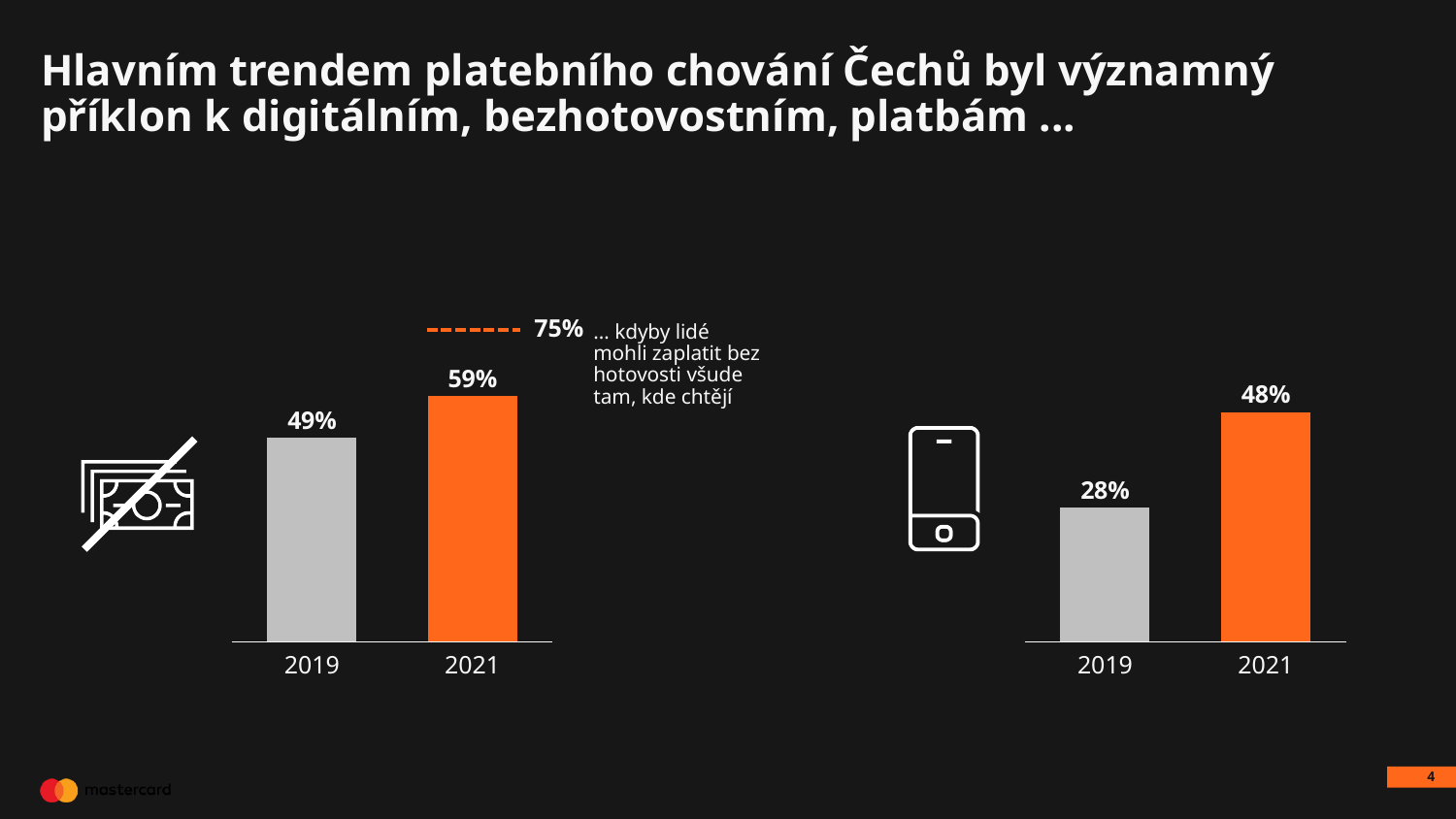
In the left chart, what value is marked by the dashed line above the bars? 75% What type of chart is the right chart? bar chart In the left chart, which year has the lower value? 2019 In the right chart, what is the value for 2021? 48% Do the values in the right chart rise or fall from 2019 to 2021? rise In the left chart, what is the value for 2019? 49% In the right chart, which year has the higher value? 2021 How many bars are shown in the left chart? 2 In the right chart, what is the difference between the 2021 and 2019 values? 20% In the left chart, what is the value for 2021? 59% In the right chart, what is the value for 2019? 28% In the left chart, what is the difference between the 2021 and 2019 values? 10%